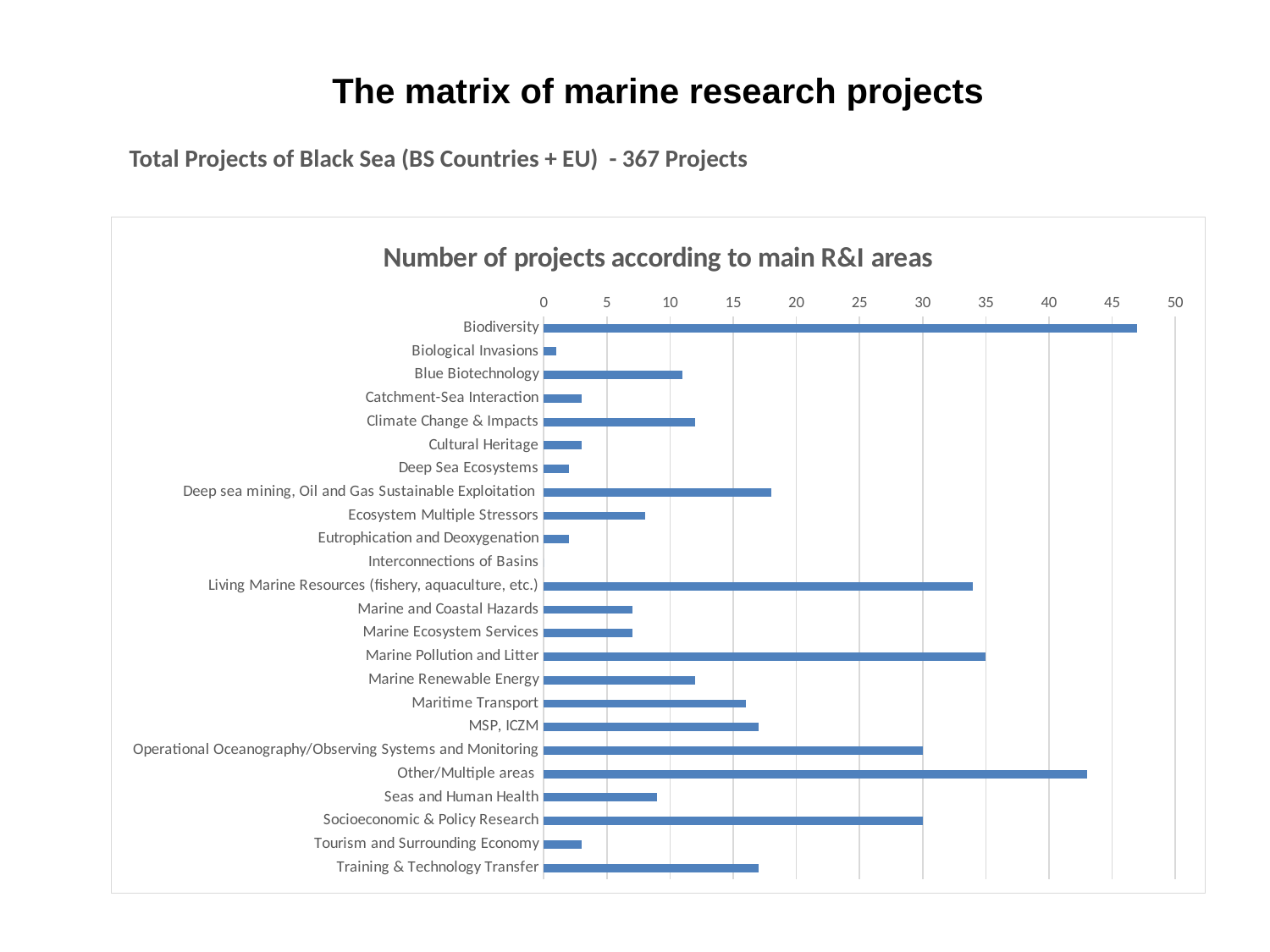
What kind of chart is shown on the slide? bar chart Which R&I area has the highest number of projects? Biodiversity Which has more projects, Biodiversity or Other/Multiple areas? Biodiversity Is the value for Seas and Human Health greater or less than 10? less Which R&I area has the lowest number of projects? Interconnections of Basins Is the value for Biodiversity greater or less than 45? greater What is the title of the chart? Number of projects according to main R&I areas Which has more projects, Deep sea mining, Oil and Gas Sustainable Exploitation or Ecosystem Multiple Stressors? Deep sea mining, Oil and Gas Sustainable Exploitation Is the value for Living Marine Resources (fishery, aquaculture, etc.) greater or less than 30? greater How many R&I area categories are plotted in the chart? 24